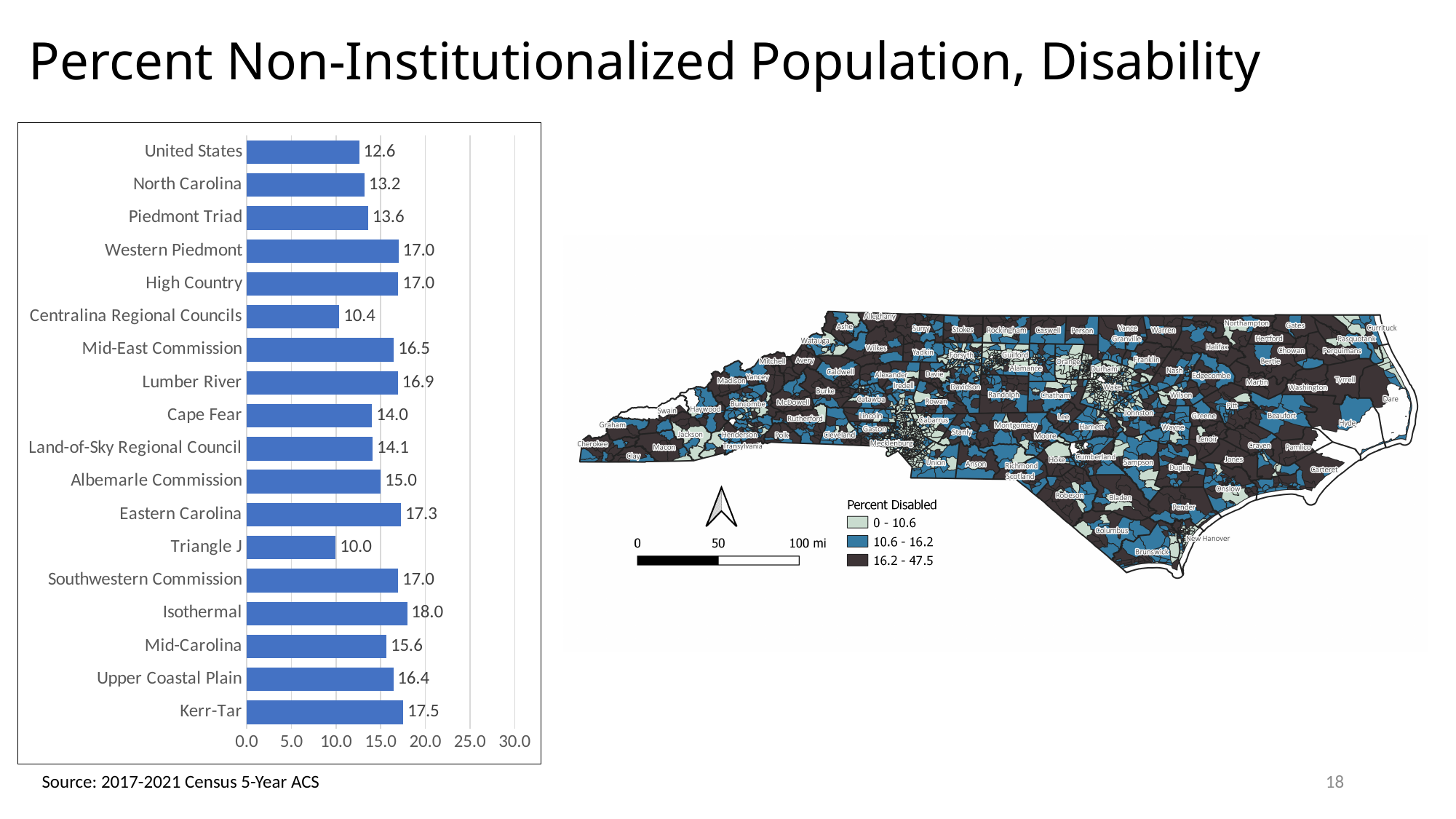
What is the difference between the values for Isothermal and Triangle J in the bar chart? 8.0 What is the difference between the values for North Carolina and United States in the bar chart? 0.6 Is the value for Centralina Regional Councils in the bar chart greater or less than 15.0? less How many categories are shown in the bar chart? 18 In the bar chart, which is larger: the value for Eastern Carolina or the value for Cape Fear? Eastern Carolina What is the value for Kerr-Tar in the bar chart? 17.5 What kind of chart is shown on the left of the slide? bar chart Which category has the lowest value in the bar chart? Triangle J What is the value for North Carolina in the bar chart? 13.2 What is the value for Isothermal in the bar chart? 18.0 What is the value for Triangle J in the bar chart? 10.0 Which category has the highest value in the bar chart? Isothermal